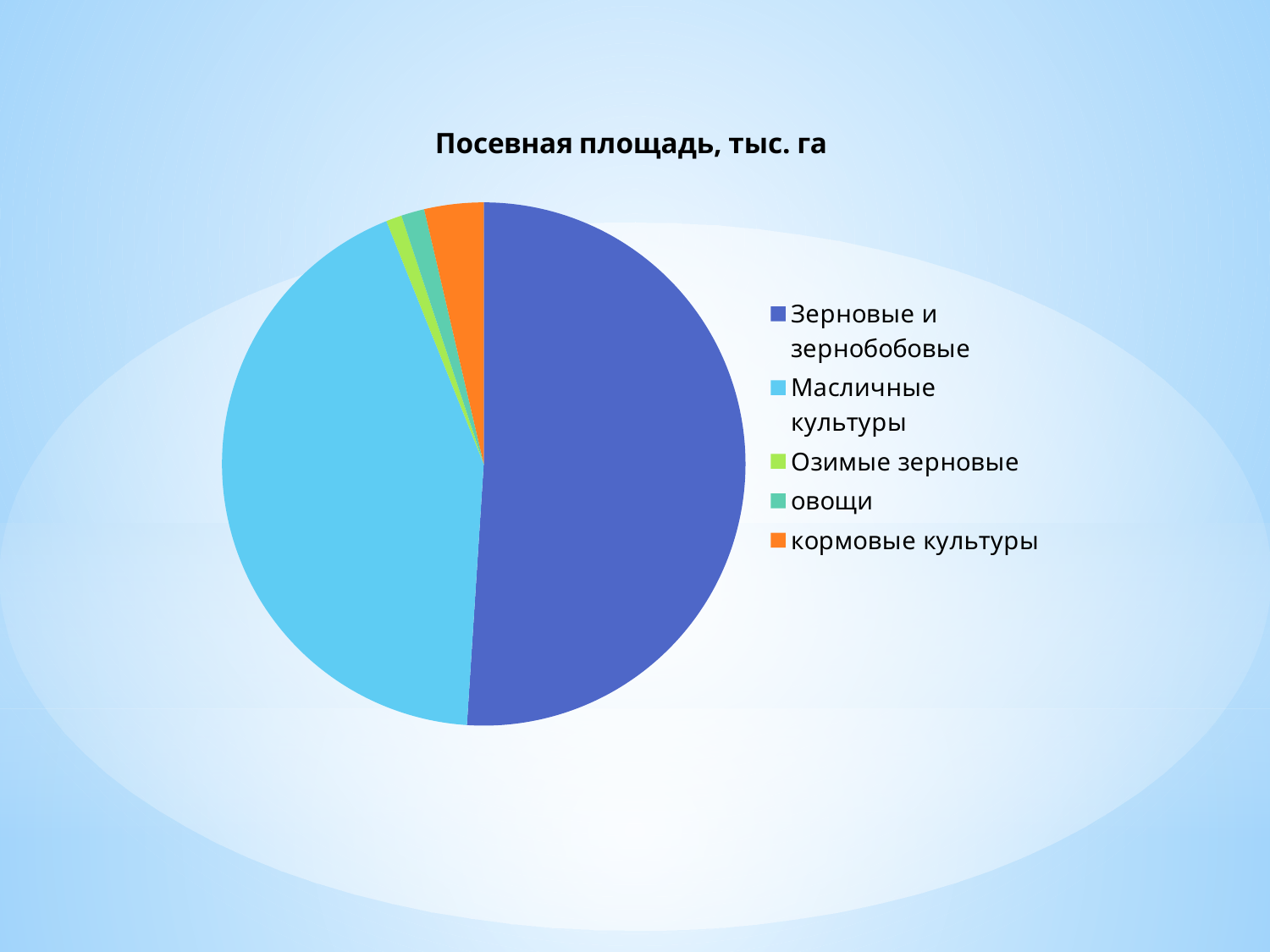
Which is larger: the slice for овощи or the slice for Озимые зерновые? овощи Which is larger: the slice for Масличные культуры or the slice for кормовые культуры? Масличные культуры Which category has the largest slice of the pie? Зерновые и зернобобовые Which category is shown in orange in the pie chart? кормовые культуры How many categories (slices) does the pie chart have? 5 Which category has the smallest slice of the pie? Озимые зерновые Which is larger: the slice for кормовые культуры or the slice for овощи? кормовые культуры What is the title of the chart? Посевная площадь, тыс. га What kind of chart is shown on the slide? pie chart How many entries does the legend list? 5